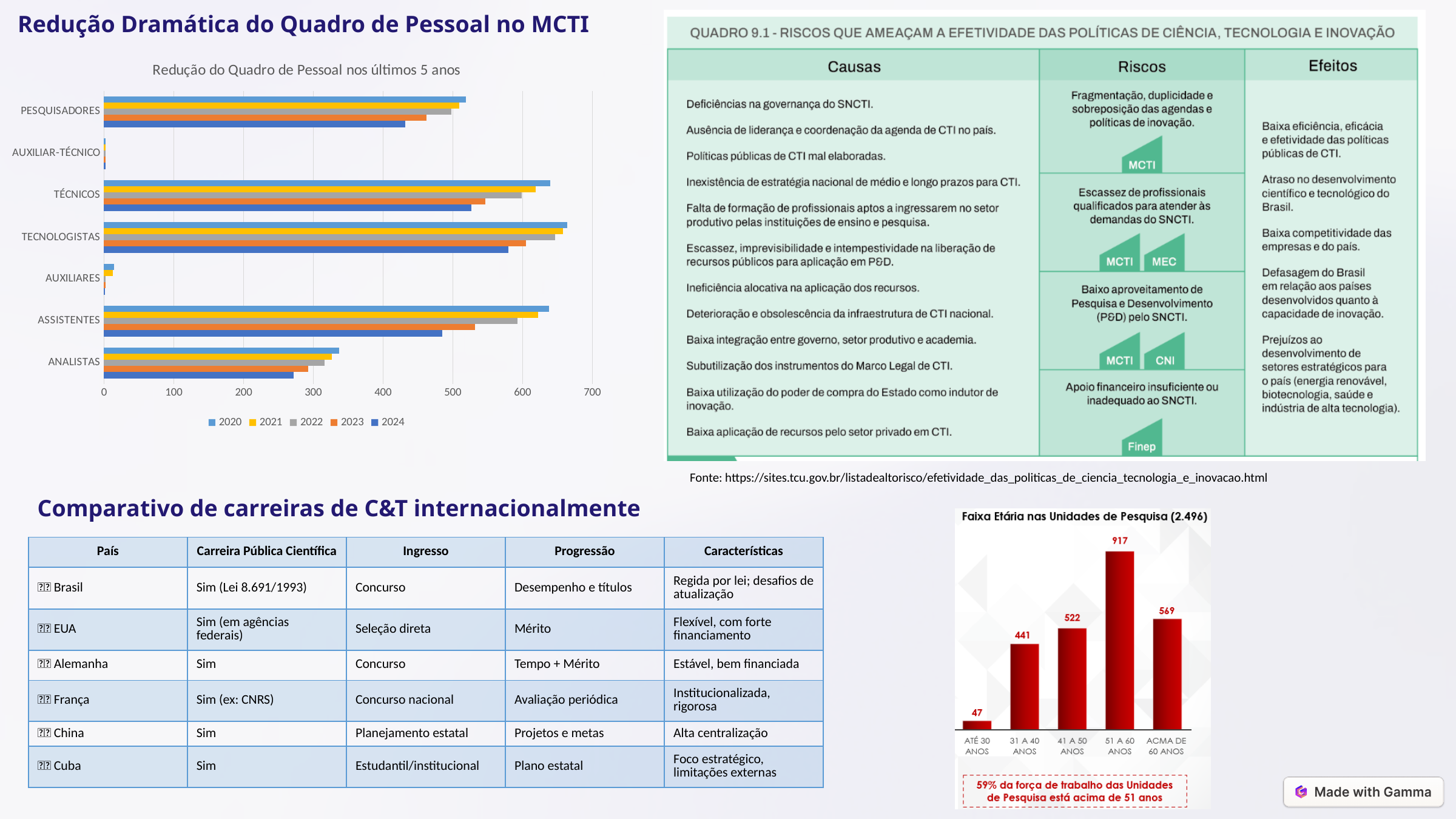
In the chart 'Faixa Etária nas Unidades de Pesquisa (2.496)', what is the value for '51 A 60 ANOS'? 917 In the chart 'Redução do Quadro de Pessoal nos últimos 5 anos', how many series does the legend list? 5 In the chart 'Faixa Etária nas Unidades de Pesquisa (2.496)', how many age groups are shown? 5 In the chart 'Faixa Etária nas Unidades de Pesquisa (2.496)', which is larger: the value for '41 A 50 ANOS' or for 'ACIMA DE 60 ANOS'? ACIMA DE 60 ANOS In the chart 'Redução do Quadro de Pessoal nos últimos 5 anos', how many categories are shown on the vertical axis? 7 In the chart 'Redução do Quadro de Pessoal nos últimos 5 anos', is the 2024 value for PESQUISADORES greater or less than 500? less In the chart 'Faixa Etária nas Unidades de Pesquisa (2.496)', what is the value for 'ATÉ 30 ANOS'? 47 In the chart 'Faixa Etária nas Unidades de Pesquisa (2.496)', what is the difference between the values for '51 A 60 ANOS' and 'ACIMA DE 60 ANOS'? 348 In the chart 'Faixa Etária nas Unidades de Pesquisa (2.496)', which age group has the highest value? 51 A 60 ANOS In the chart 'Faixa Etária nas Unidades de Pesquisa (2.496)', which age group has the lowest value? ATÉ 30 ANOS What kind of chart is 'Redução do Quadro de Pessoal nos últimos 5 anos'? Bar chart